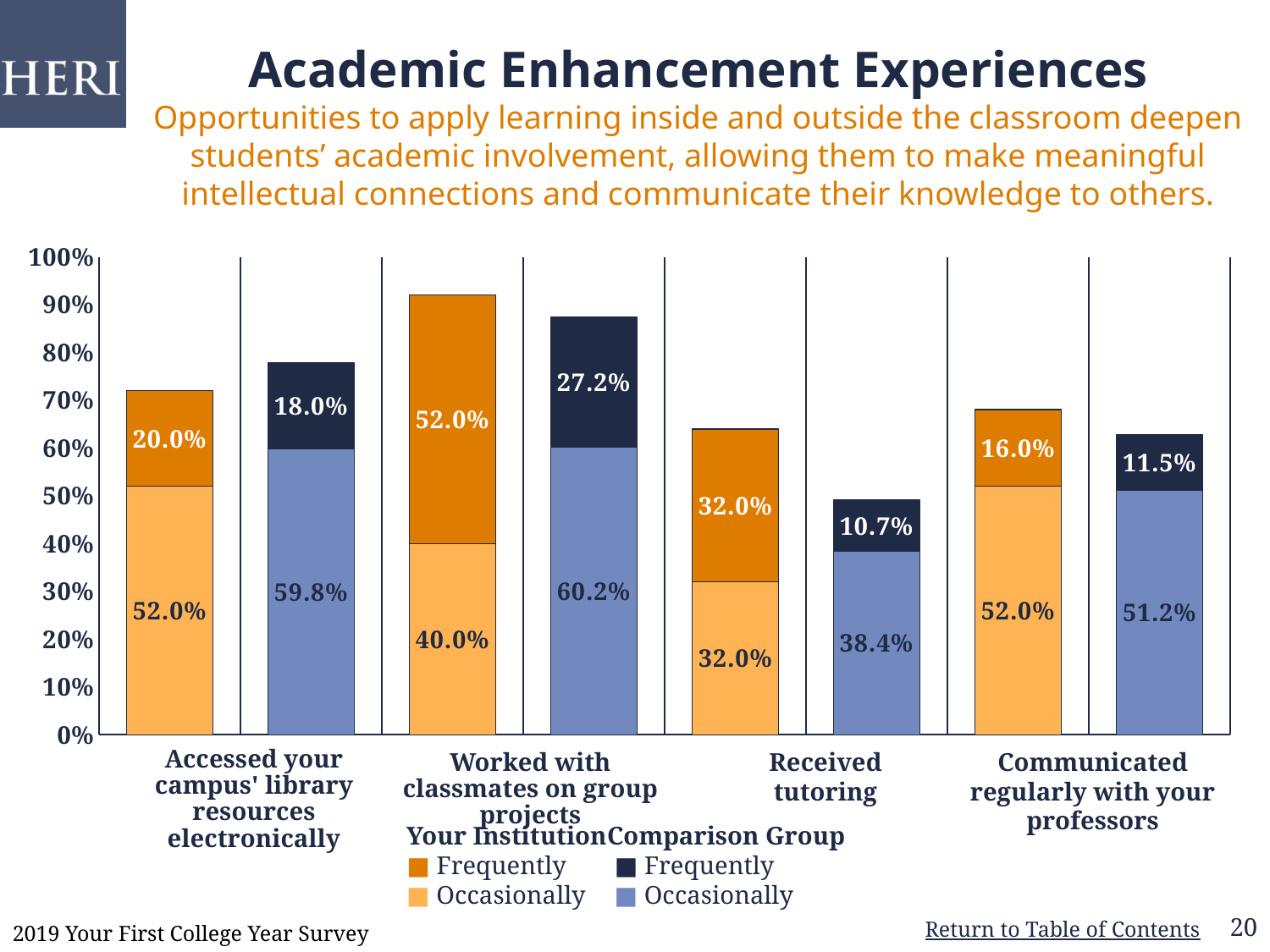
What percentage of students at Your Institution reported occasionally communicating regularly with their professors? 52.0% What percentage of students at Your Institution reported frequently working with classmates on group projects? 52.0% What is the total percentage (frequently plus occasionally) for Your Institution for 'Worked with classmates on group projects'? 92.0% What kind of chart is shown on the slide? Stacked bar chart What percentage of the Comparison Group reported occasionally accessing campus library resources electronically? 59.8% How many activity categories are shown on the x axis of the chart? 4 Which activity has the highest combined (frequently plus occasionally) percentage for Your Institution? Worked with classmates on group projects What is the difference between Your Institution's and the Comparison Group's 'Frequently' values for 'Worked with classmates on group projects'? 24.8 percentage points For 'Received tutoring', which group has the larger 'Frequently' value, Your Institution or the Comparison Group? Your Institution What percentage of the Comparison Group reported frequently receiving tutoring? 10.7% What is the total percentage (frequently plus occasionally) for the Comparison Group for 'Received tutoring'? 49.1% Which activity has the lowest combined (frequently plus occasionally) percentage for the Comparison Group? Received tutoring